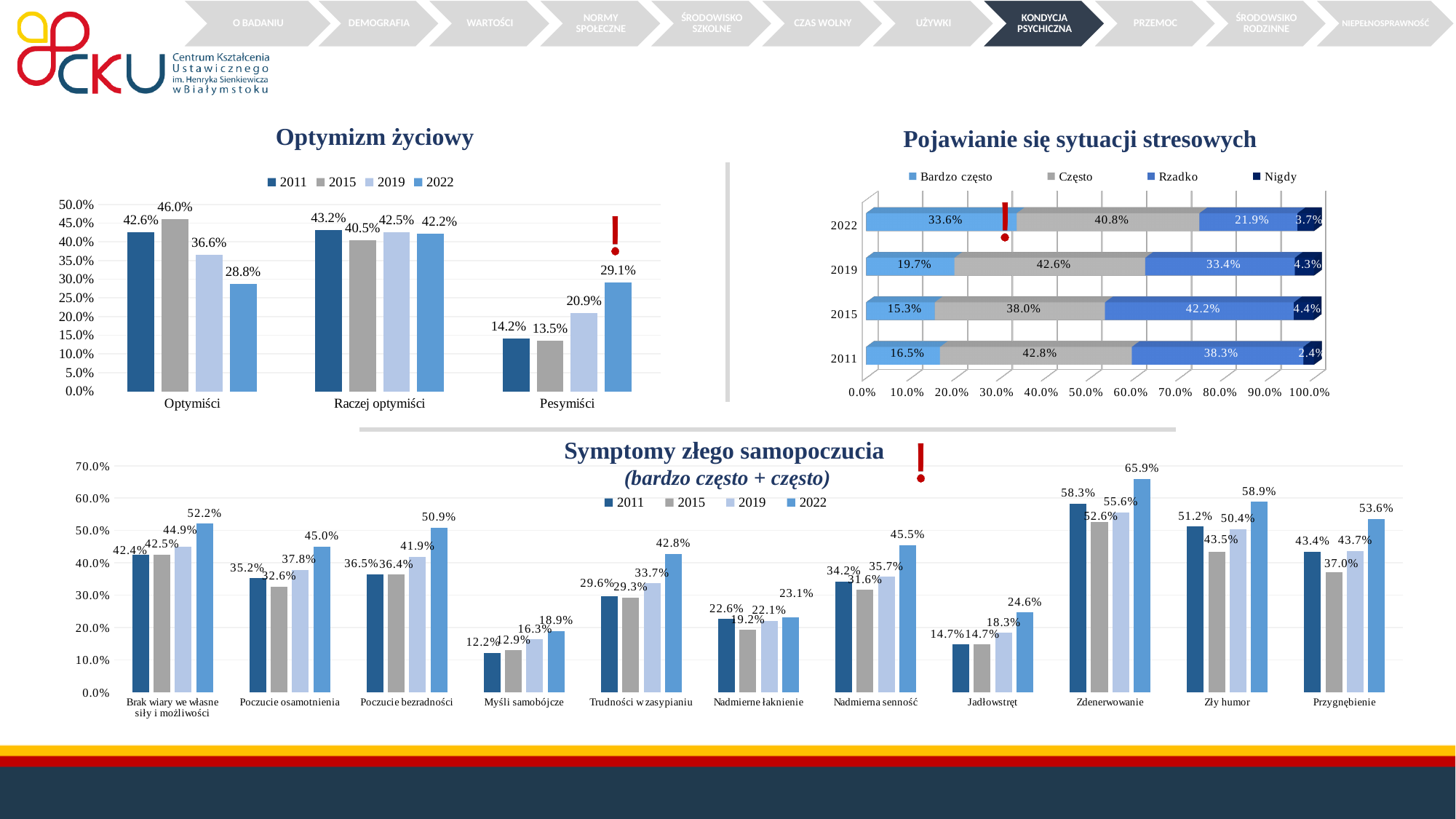
In the 'Pojawianie się sytuacji stresowych' chart, what is the 'Nigdy' value for 2011? 2.4% In the 'Pojawianie się sytuacji stresowych' chart, which year has the highest 'Bardzo często' value? 2022 In the 'Optymizm życiowy' chart, which year has the highest value for Optymiści? 2015 In the 'Symptomy złego samopoczucia' chart, which category has the lowest 2011 value? Myśli samobójcze In the 'Optymizm życiowy' chart, how many series does the legend list? 4 What kind of chart is 'Pojawianie się sytuacji stresowych'? Stacked horizontal bar chart In the 'Optymizm życiowy' chart, what is the value for Pesymiści in 2022? 29.1% In the 'Symptomy złego samopoczucia' chart, how many symptom categories are shown on the x axis? 11 In the 'Pojawianie się sytuacji stresowych' chart, what is the 'Często' value for 2019? 42.6% In the 'Symptomy złego samopoczucia' chart, is the 2022 value for Przygnębienie larger than the 2022 value for Poczucie bezradności? Yes In the 'Optymizm życiowy' chart, what is the difference between the 2022 and 2011 values for Pesymiści? 14.9% In the 'Symptomy złego samopoczucia' chart, what is the 2022 value for Zdenerwowanie? 65.9%